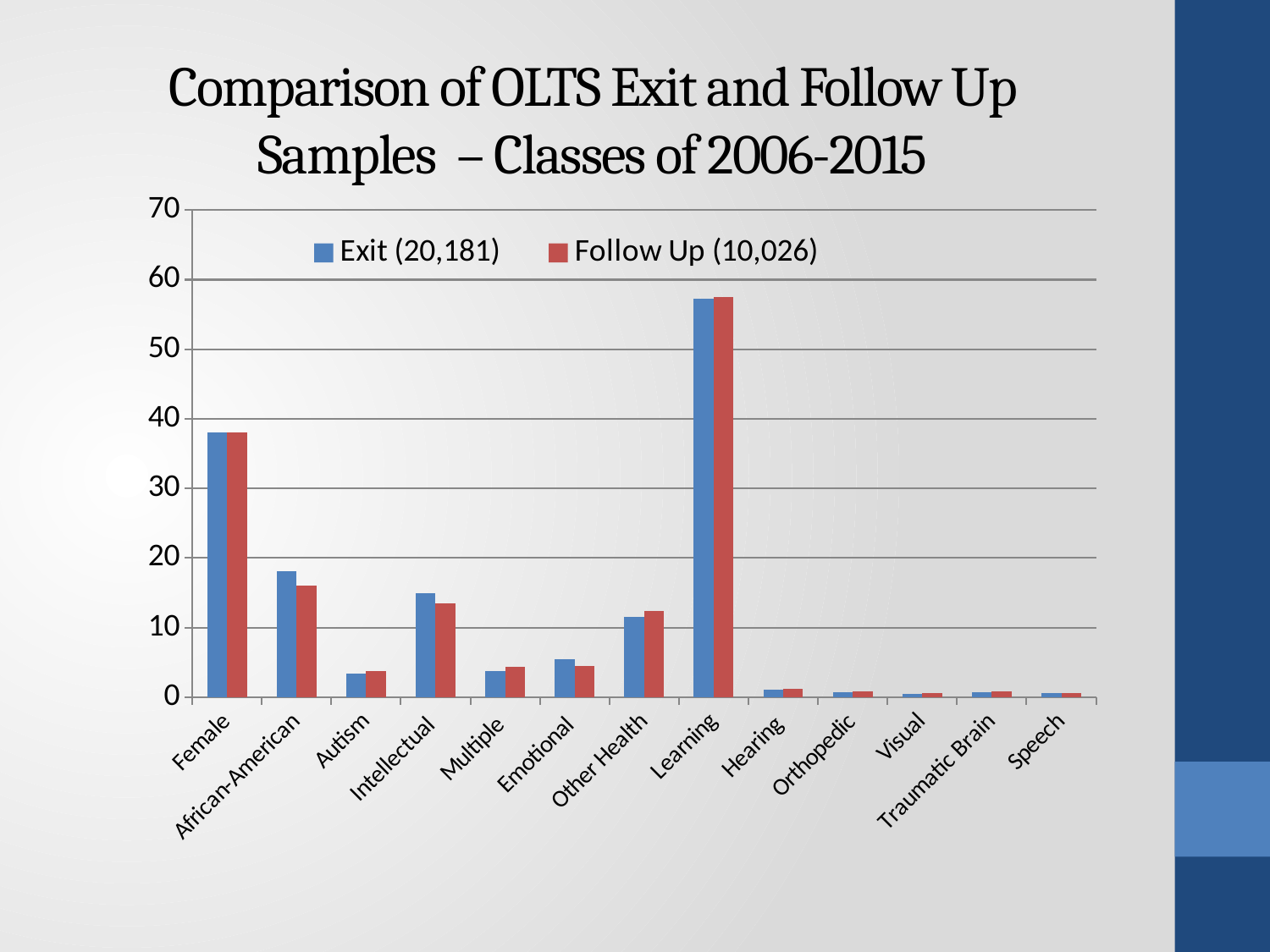
Is the Exit (20,181) value for Learning greater or less than 50? greater Which category has the highest value for the Follow Up (10,026) series? Learning How many series does the legend list? 2 How many categories are shown on the x axis? 13 For Other Health, which series has the larger value, Exit (20,181) or Follow Up (10,026)? Follow Up (10,026) For African-American, which series has the larger value, Exit (20,181) or Follow Up (10,026)? Exit (20,181) Is the Exit (20,181) value for African-American greater or less than 20? less What is the title of the chart? Comparison of OLTS Exit and Follow Up Samples – Classes of 2006-2015 Is the Exit (20,181) value for Female greater or less than 30? greater Which category has the highest value for the Exit (20,181) series? Learning What kind of chart is shown on the slide? bar chart